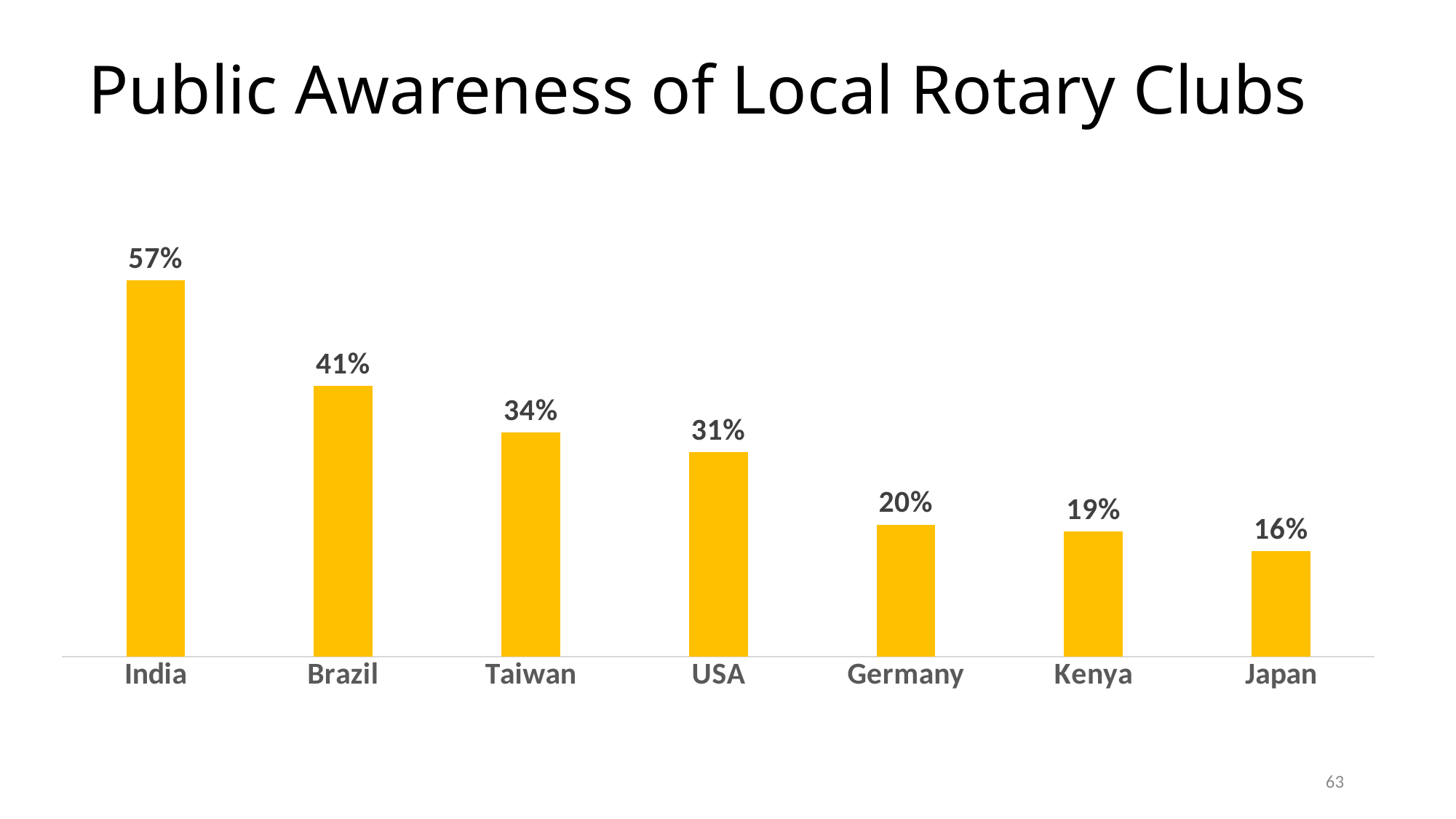
What is the value for Germany? 20% What kind of chart is shown on the slide? Bar chart Which is larger, the value for Brazil or the value for Taiwan? Brazil What is the value for Japan? 16% What is the value for India? 57% What is the difference between the values for Taiwan and USA? 3% What is the title of the chart? Public Awareness of Local Rotary Clubs What is the difference between the values for India and Brazil? 16% How many countries are shown in the chart? 7 Which country has the highest value? India Do the values rise or fall from left to right across the countries? Fall Which country has the lowest value? Japan